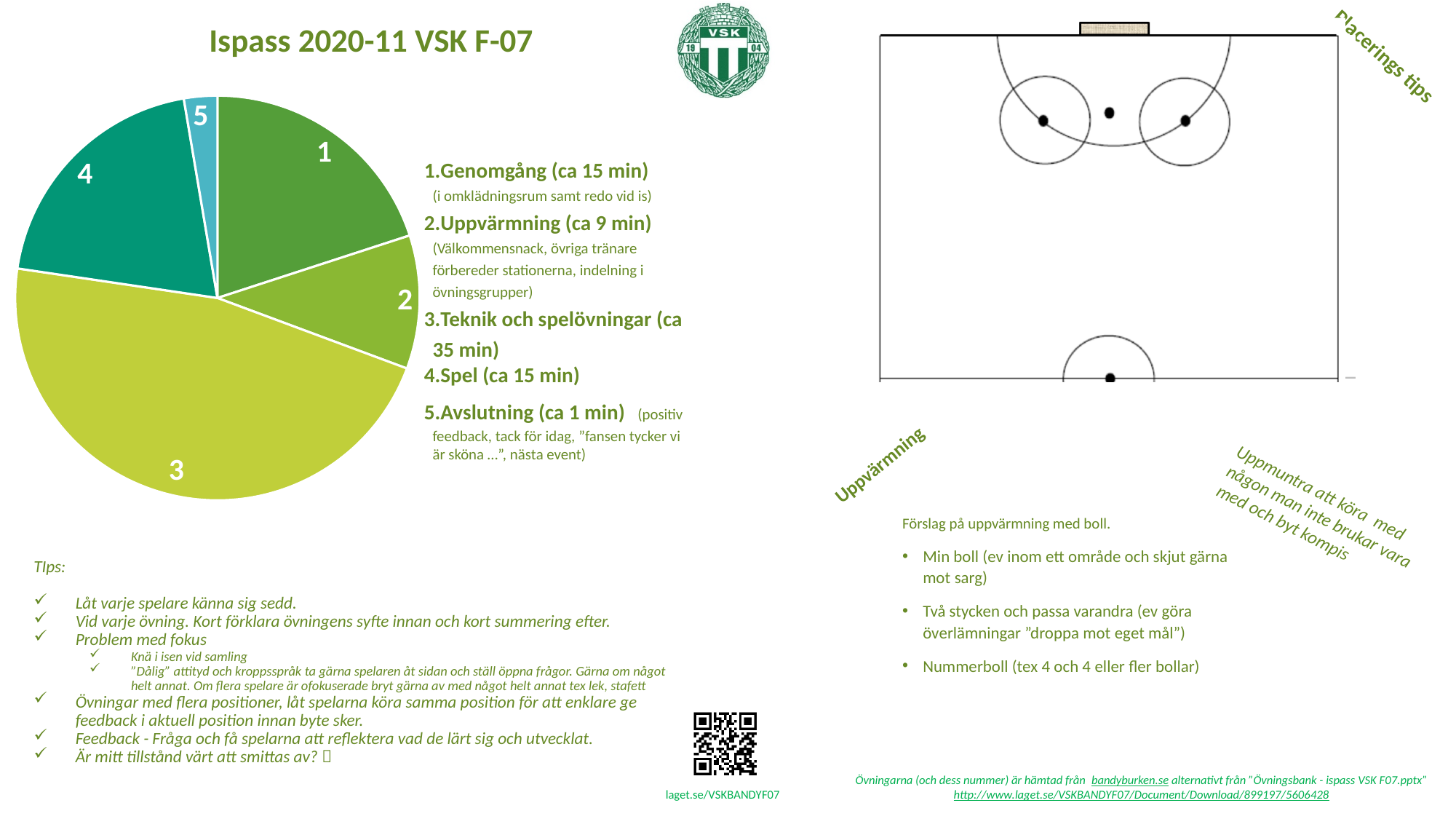
Which slice of the pie chart is the smallest? 5 Which slice of the pie chart is the largest? 3 Which slice is larger in the pie chart, slice 2 or slice 4? 4 What kind of chart is shown on the left of the slide? pie chart According to the text next to the pie chart, how long is item 3, Teknik och spelövningar? ca 35 min What is the title shown above the pie chart? Ispass 2020-11 VSK F-07 Which slice is larger in the pie chart, slice 1 or slice 2? 1 Which slice is larger in the pie chart, slice 3 or slice 4? 3 How many slices does the pie chart have? 5 According to the text next to the pie chart, how long is item 5, Avslutning? ca 1 min What colour is slice 5 in the pie chart? light blue